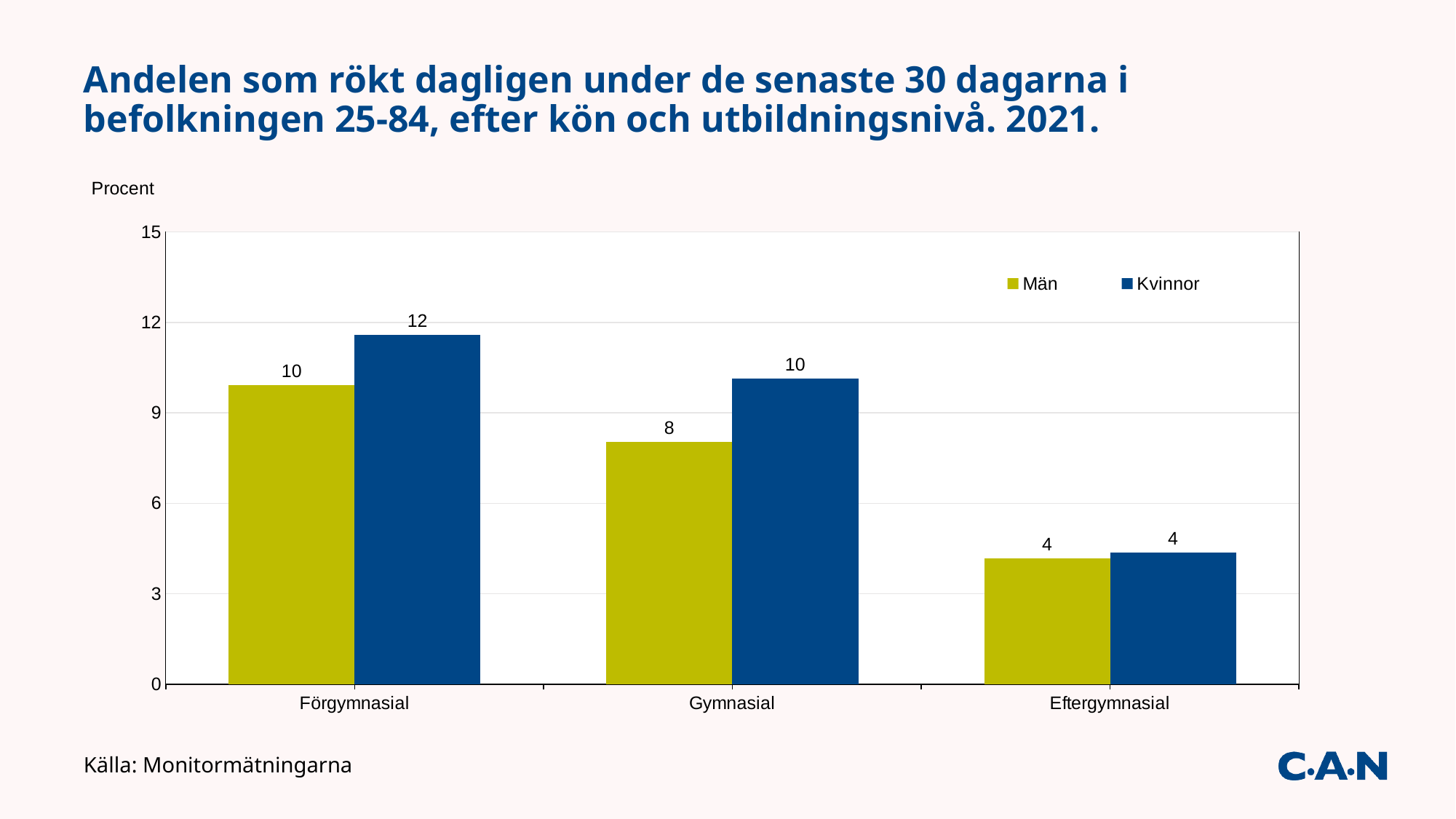
Which education level has the highest value for Kvinnor? Förgymnasial What is the value for Män in the Eftergymnasial category? 4 What is the difference between the Kvinnor and Män values in the Förgymnasial category? 2 Is the value for Kvinnor in the Förgymnasial category greater or less than 9? greater Do the values for Män rise or fall from Förgymnasial to Eftergymnasial? Fall What kind of chart is shown on the slide? Bar chart Which education level has the lowest value for Män? Eftergymnasial What is the value for Kvinnor in the Gymnasial category? 10 How many education level categories are shown on the x axis? 3 What is the value for Män in the Förgymnasial category? 10 How many series does the legend list? 2 Which is larger in the Gymnasial category, the value for Män or for Kvinnor? Kvinnor